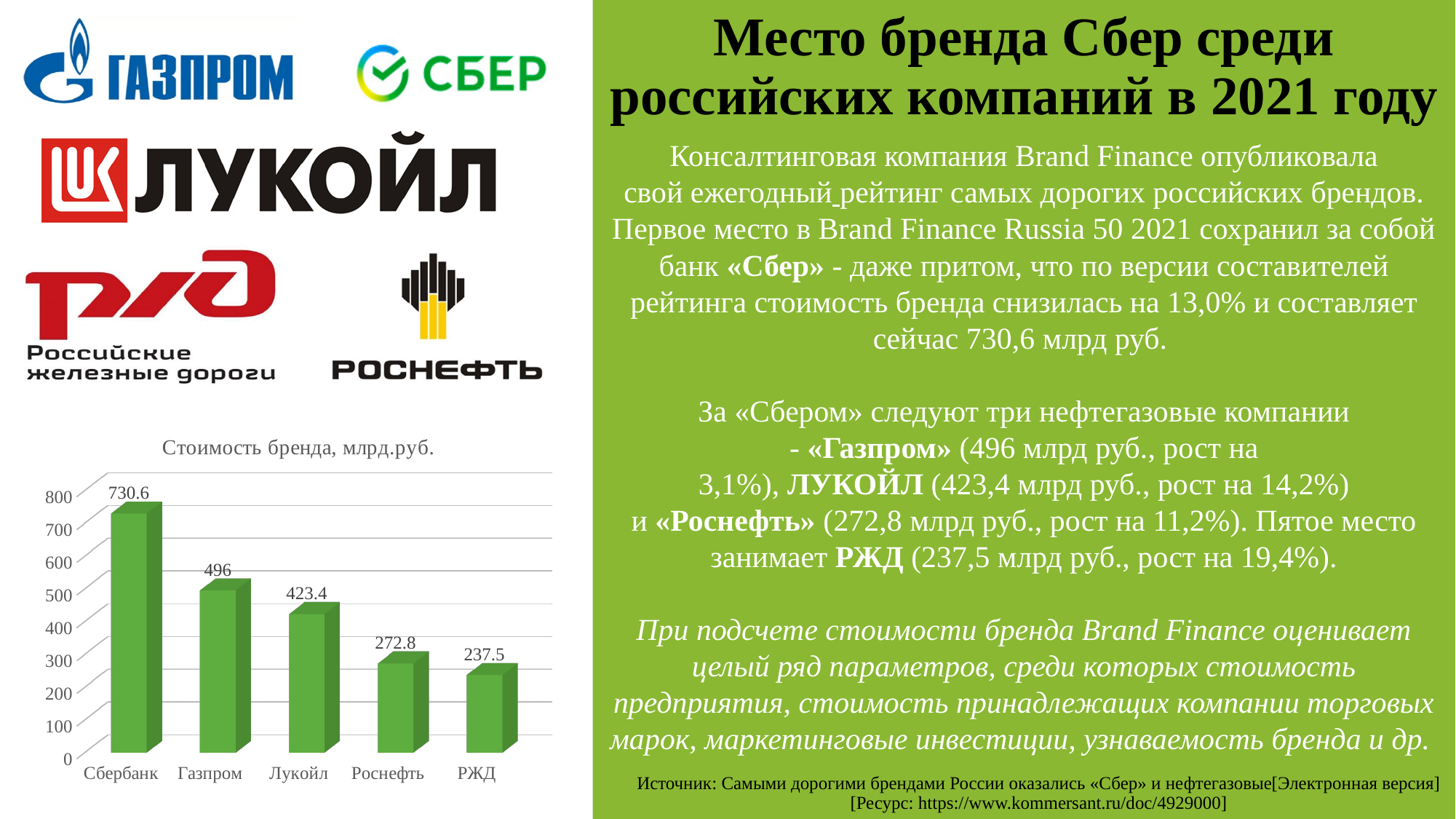
How many companies are shown in the chart? 5 Is the value for Роснефть greater or less than 300? less Which has a larger brand value, Газпром or Лукойл? Газпром What is the brand value shown for Сбербанк in the chart? 730.6 What is the difference between the brand values of Сбербанк and Газпром? 234.6 What type of chart is shown on the slide? bar chart What is the difference between the brand values of Роснефть and РЖД? 35.3 What is the brand value shown for РЖД in the chart? 237.5 What is the title of the chart? Стоимость бренда, млрд.руб. Which company has the lowest brand value in the chart? РЖД What is the brand value shown for Лукойл in the chart? 423.4 Which company has the highest brand value in the chart? Сбербанк